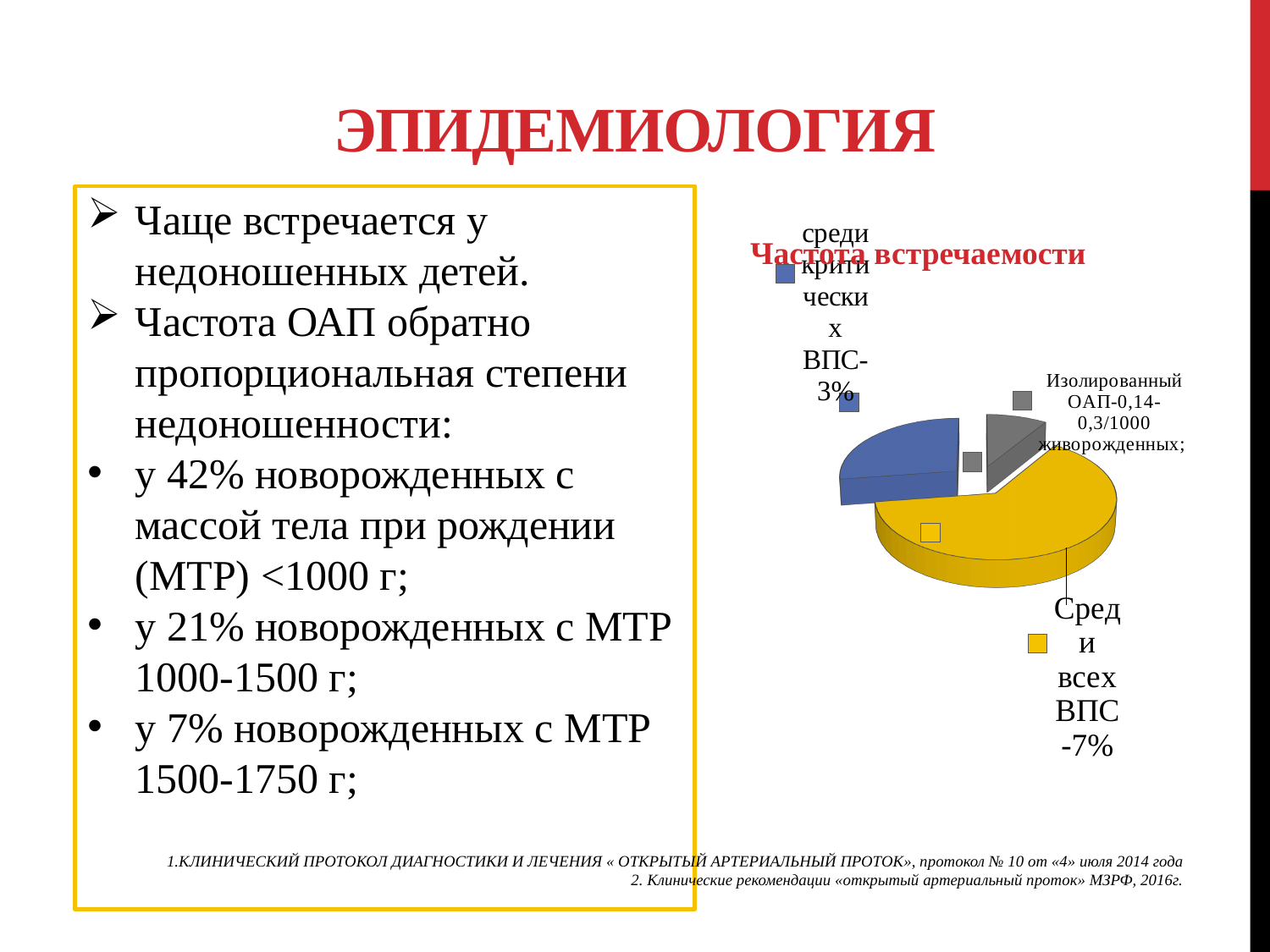
How many slices does the pie chart have? 3 What kind of chart is shown on the slide? pie chart What value is shown for the slice 'Среди всех ВПС'? 7% What value is shown for the slice 'среди критических ВПС'? 3% What value is shown for the slice 'Изолированный ОАП'? 0,14-0,3/1000 живорожденных What is the title of the chart? Частота встречаемости What is the difference between the value for 'Среди всех ВПС' and the value for 'среди критических ВПС'? 4% Which slice of the pie chart is the largest? Среди всех ВПС Which slice of the pie chart is the smallest? Изолированный ОАП Which slice is larger, 'среди критических ВПС' or 'Среди всех ВПС'? Среди всех ВПС What colour is the slice for 'Среди всех ВПС'? yellow